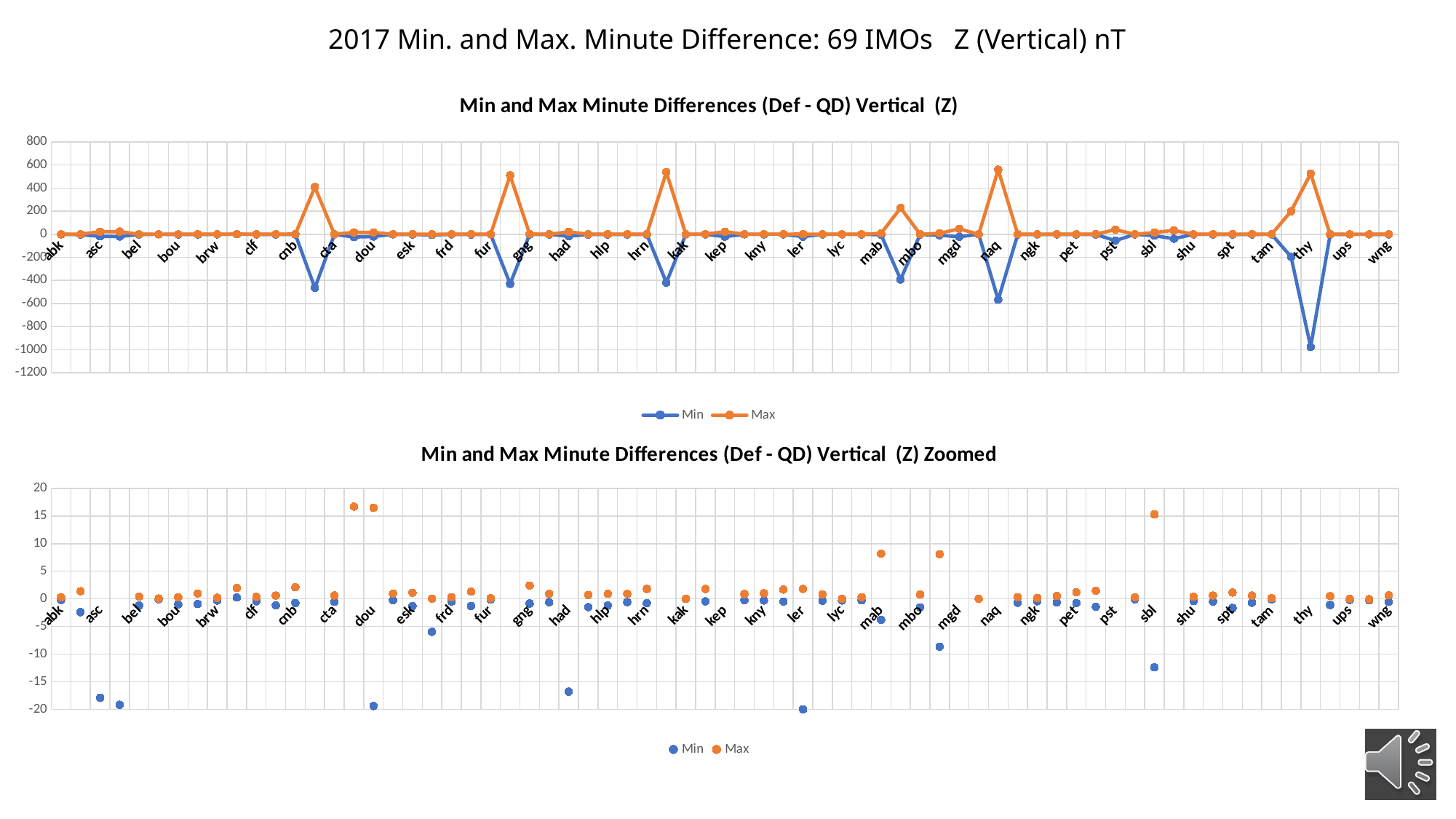
In the bottom (Zoomed) chart, is the Min value for ler greater or less than -15? less In the top chart, which category has the lowest Min value? thy In the top chart, is the Min value for thy greater or less than -800? less In the top chart, is the Max value for cta greater or less than 200? less In the top chart, which is larger: the Max value for mbo or the Max value for naq? naq In the bottom (Zoomed) chart, which is larger: the Max value for mab or the Max value for ngk? mab How many series does the legend of the top chart list? 2 What are the two legend entries shown for the top chart? Min and Max What kind of chart is the top chart titled 'Min and Max Minute Differences (Def - QD) Vertical (Z)'? line chart